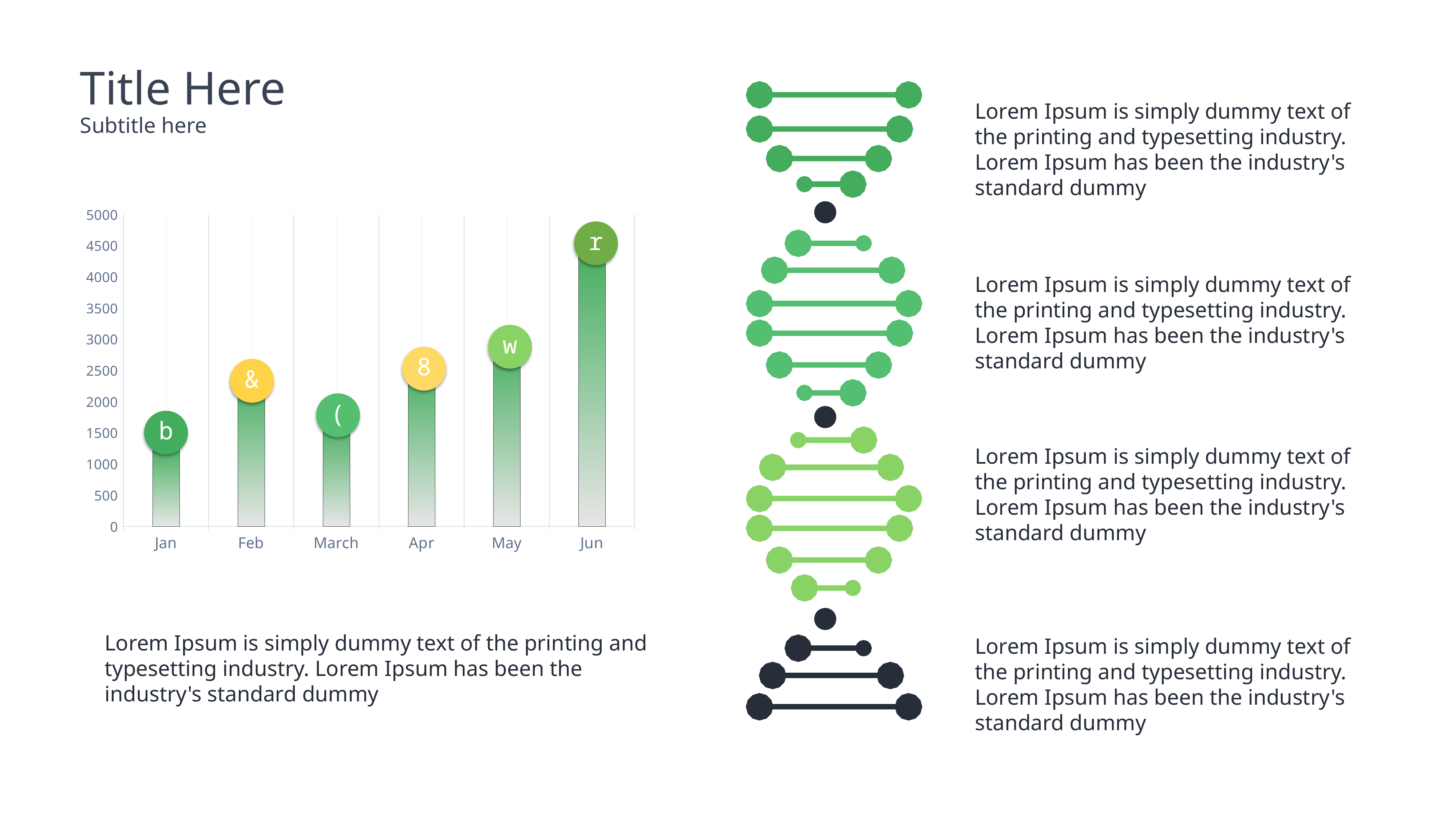
Is the value for March greater or less than 2500? less Is the value for May greater or less than 2500? greater What kind of chart is shown on the left of the slide? bar chart Is the value for Apr greater or less than 2000? greater Which is larger, the value for Feb or the value for March? Feb Which month has the lowest bar in the chart? Jan What is the highest value shown on the y axis of the chart? 5000 How many months are shown on the x axis of the bar chart? 6 Which is larger, the value for Jun or the value for May? Jun Which month has the highest bar in the chart? Jun